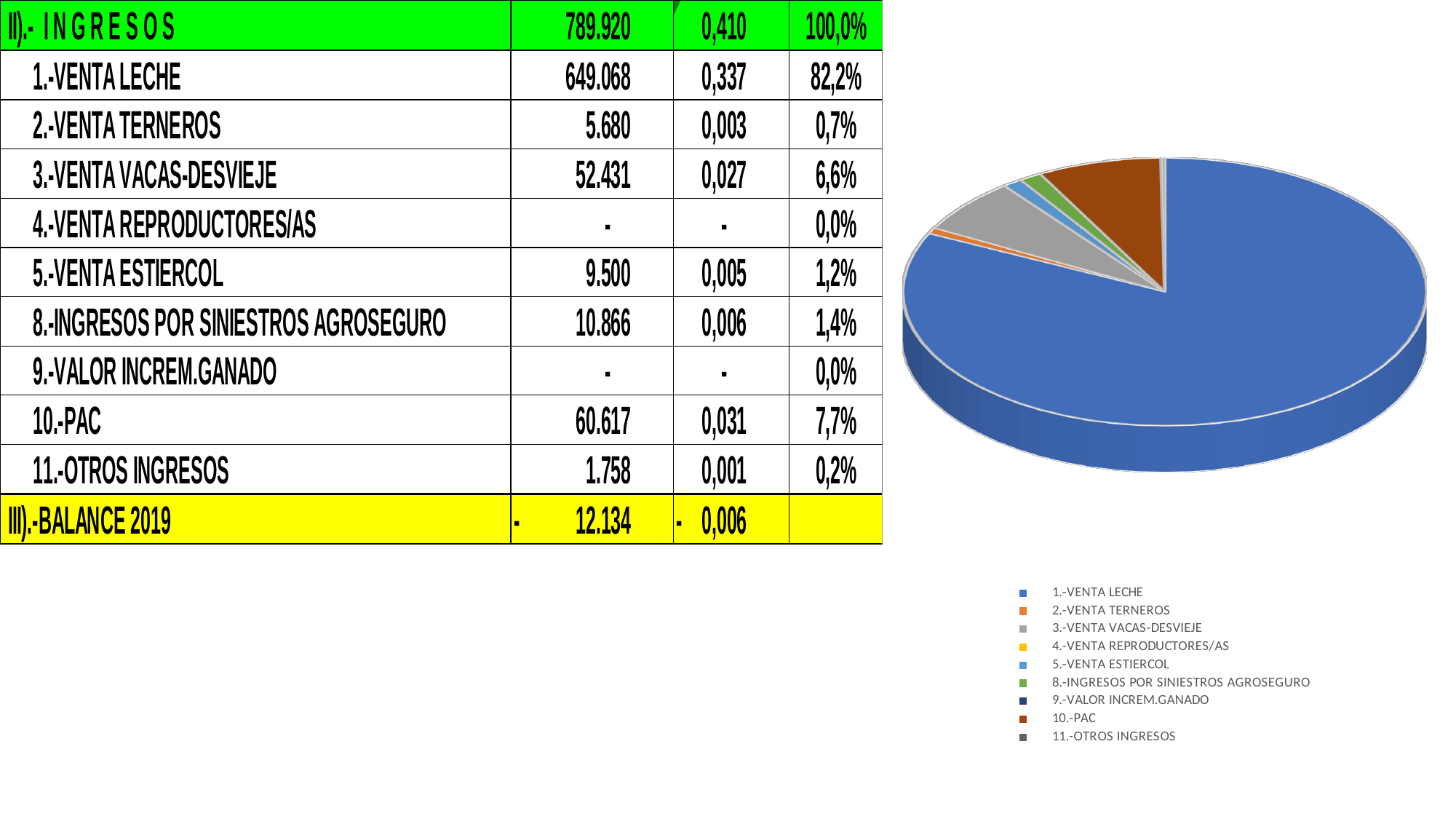
How many entries does the pie chart's legend list? 9 What share of the pie does 1.-VENTA LECHE represent, according to the table on the slide? 82,2% Which slice is larger in the pie chart: 3.-VENTA VACAS-DESVIEJE or 5.-VENTA ESTIERCOL? 3.-VENTA VACAS-DESVIEJE What share of the pie does 10.-PAC represent, according to the table on the slide? 7,7% What is the value of 1.-VENTA LECHE in the table on the slide? 649.068 What kind of chart is shown on the slide? Pie chart Which slice is larger in the pie chart: 10.-PAC or 2.-VENTA TERNEROS? 10.-PAC What share of the pie does 3.-VENTA VACAS-DESVIEJE represent, according to the table on the slide? 6,6% What is the total value of II).- INGRESOS shown in the table on the slide? 789.920 Which category has the largest slice in the pie chart? 1.-VENTA LECHE What colour is the slice for 10.-PAC in the pie chart? Brown What colour is the largest slice of the pie chart? Blue